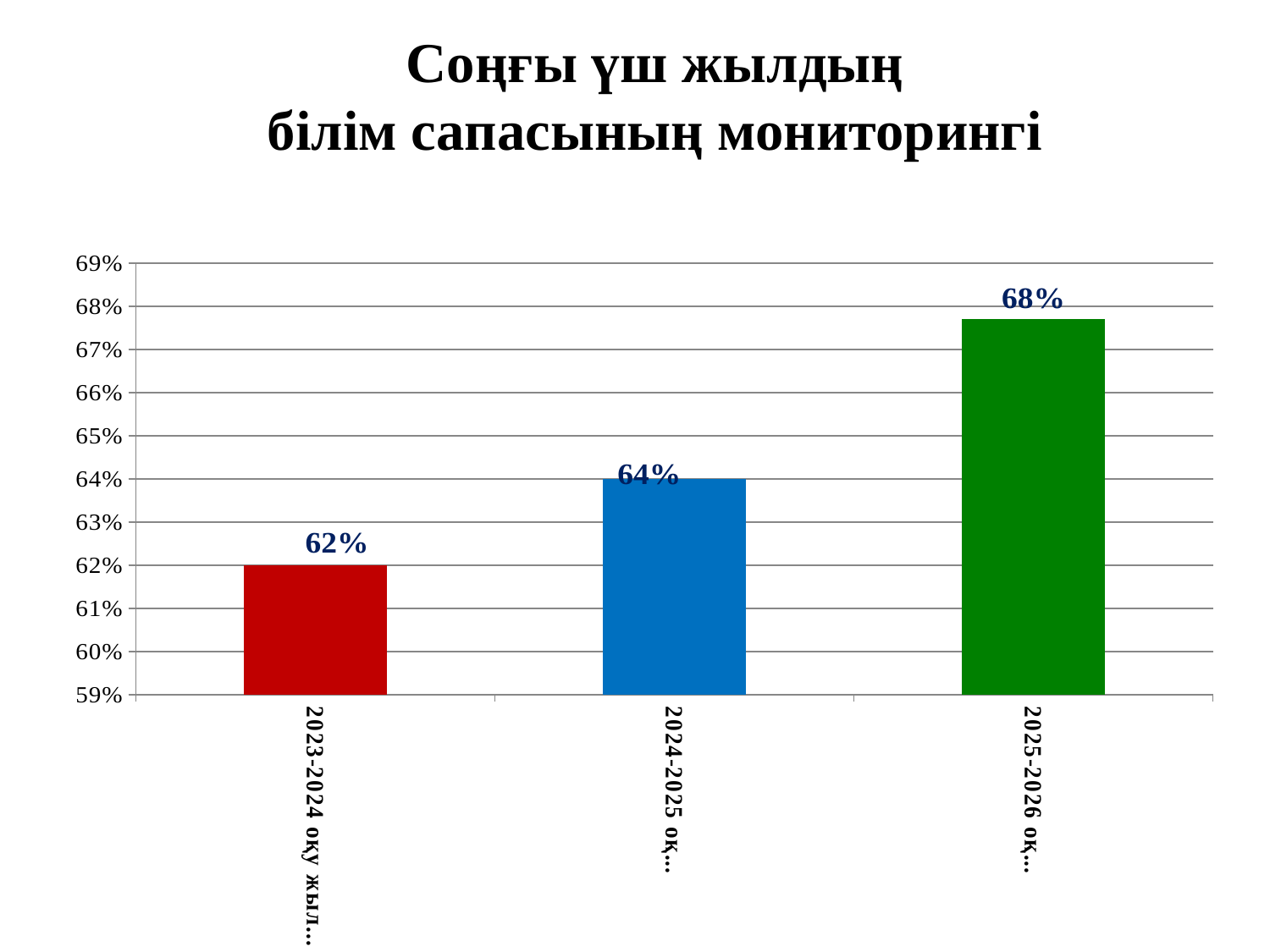
Do the values rise or fall from 2023-2024 to 2025-2026? Rise Is the value for 2025-2026 greater or less than 65%? greater How many academic years are shown on the chart? 3 What value is shown for the 2025-2026 academic year? 68% What is the difference between the values for 2025-2026 and 2023-2024? 6 percentage points Which academic year has the lowest value? 2023-2024 Which academic year has the highest value? 2025-2026 What kind of chart is shown on the slide? Bar chart What value is shown for the 2023-2024 academic year? 62% What is the difference between the values for 2024-2025 and 2023-2024? 2 percentage points Which is larger, the value for 2024-2025 or the value for 2025-2026? 2025-2026 What value is shown for the 2024-2025 academic year? 64%